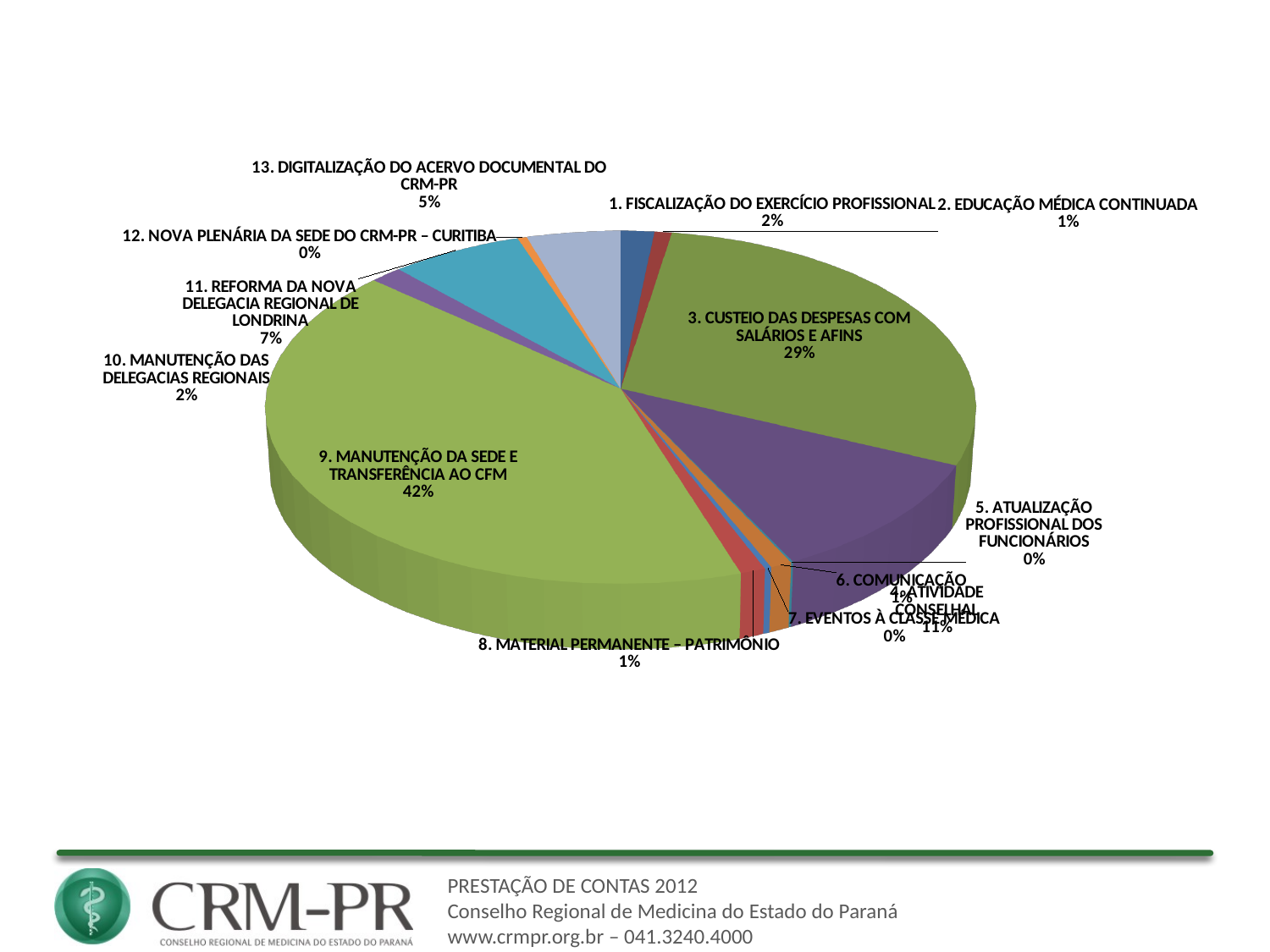
Which category has the largest slice of the pie? 9. MANUTENÇÃO DA SEDE E TRANSFERÊNCIA AO CFM What is the difference in percentage points between "9. MANUTENÇÃO DA SEDE E TRANSFERÊNCIA AO CFM" and "3. CUSTEIO DAS DESPESAS COM SALÁRIOS E AFINS"? 13 percentage points What share of the pie does "9. MANUTENÇÃO DA SEDE E TRANSFERÊNCIA AO CFM" represent? 42% What share of the pie does "3. CUSTEIO DAS DESPESAS COM SALÁRIOS E AFINS" represent? 29% What kind of chart is shown on the slide? pie chart What percentage is shown for "11. REFORMA DA NOVA DELEGACIA REGIONAL DE LONDRINA"? 7% What percentage is shown for "1. FISCALIZAÇÃO DO EXERCÍCIO PROFISSIONAL"? 2% What percentage is shown for "12. NOVA PLENÁRIA DA SEDE DO CRM-PR – CURITIBA"? 0% How many categories are labelled on the pie chart? 13 What percentage is shown for "2. EDUCAÇÃO MÉDICA CONTINUADA"? 1% Which is larger: the share for "11. REFORMA DA NOVA DELEGACIA REGIONAL DE LONDRINA" or for "13. DIGITALIZAÇÃO DO ACERVO DOCUMENTAL DO CRM-PR"? 11. REFORMA DA NOVA DELEGACIA REGIONAL DE LONDRINA What percentage is shown for "13. DIGITALIZAÇÃO DO ACERVO DOCUMENTAL DO CRM-PR"? 5%